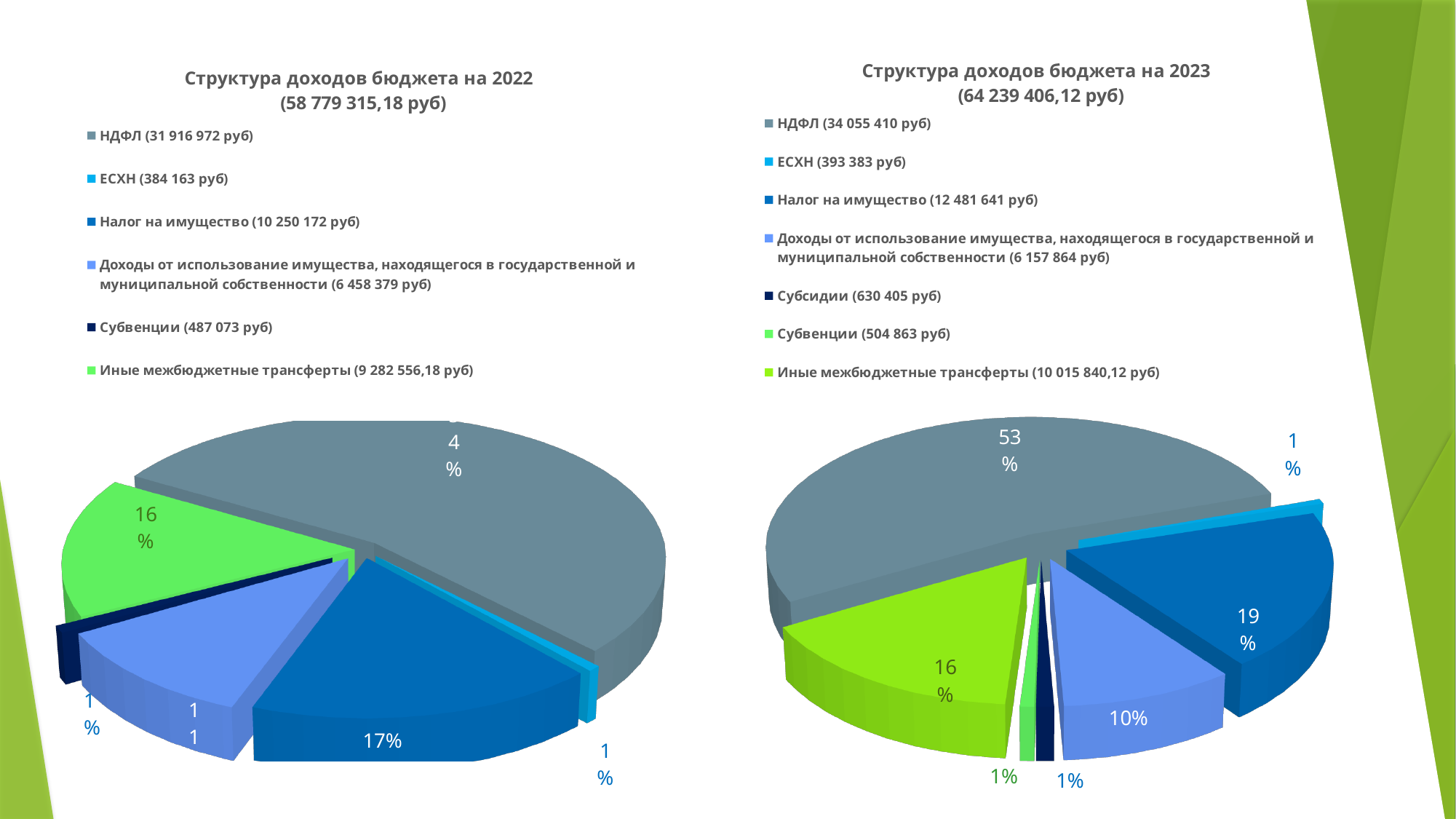
In the chart 'Структура доходов бюджета на 2023', what share of the pie is Доходы от использование имущества, находящегося в государственной и муниципальной собственности? 10% In the chart 'Структура доходов бюджета на 2023', which category has the largest slice? НДФЛ In the chart 'Структура доходов бюджета на 2022', what share of the pie is Иные межбюджетные трансферты? 16% In the chart 'Структура доходов бюджета на 2023', by how many percentage points does the Налог на имущество slice exceed the Иные межбюджетные трансферты slice? 3 percentage points What kind of chart is used on the slide for the 2022 budget income structure? Pie chart According to the legend of the chart 'Структура доходов бюджета на 2022', what is the amount for ЕСХН? 384 163 руб In the chart 'Структура доходов бюджета на 2023', how many categories does the legend list? 7 In the chart 'Структура доходов бюджета на 2023', which slice is larger: Налог на имущество or Иные межбюджетные трансферты? Налог на имущество In the chart 'Структура доходов бюджета на 2023', what share of the pie is Налог на имущество? 19% In the chart 'Структура доходов бюджета на 2023', what share of the pie is НДФЛ? 53% In the chart 'Структура доходов бюджета на 2022', what share of the pie is Налог на имущество? 17% In the chart 'Структура доходов бюджета на 2022', how many categories does the legend list? 6